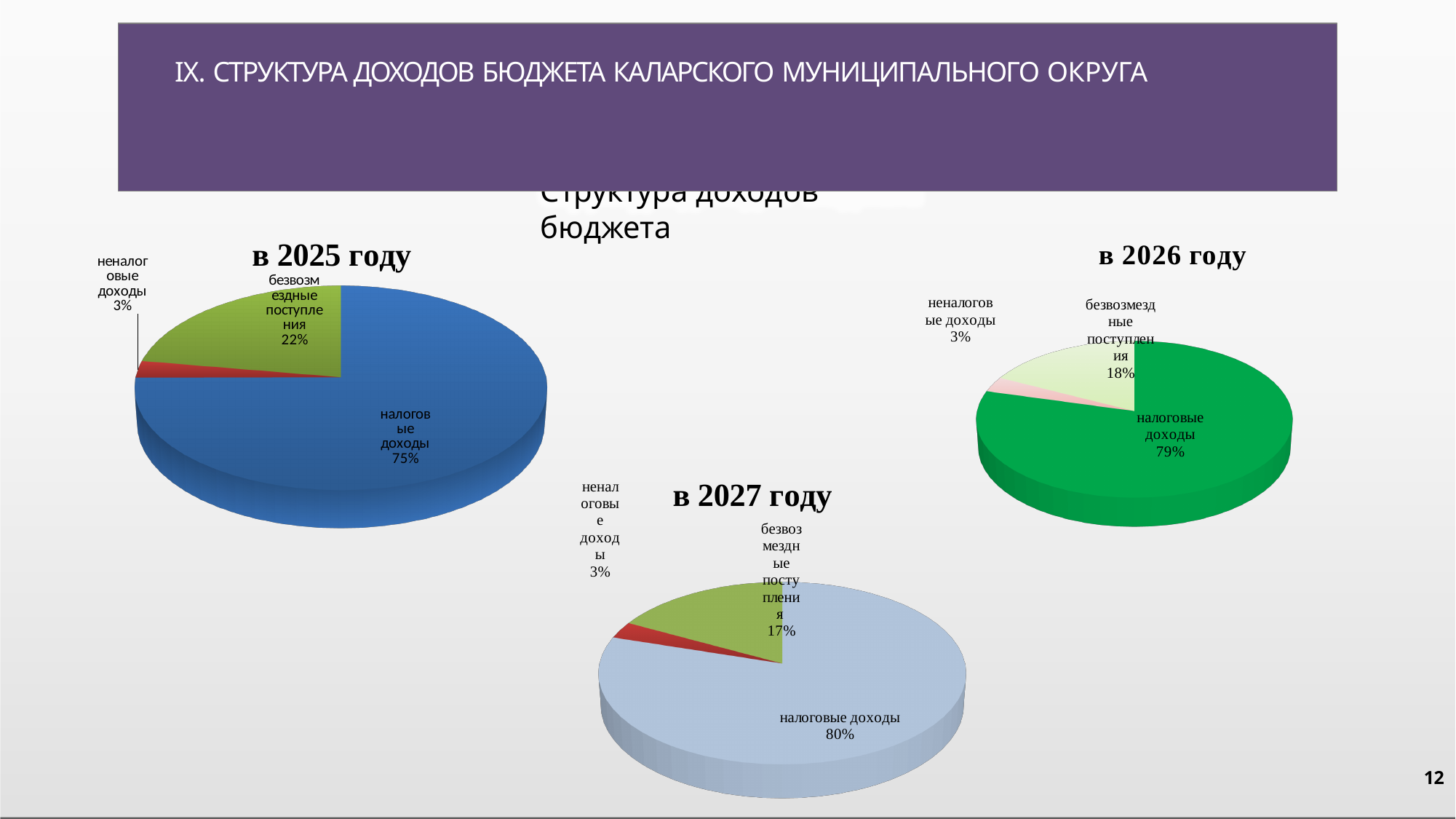
In the chart titled "в 2027 году", what share is shown for "налоговые доходы"? 80% In the chart titled "в 2027 году", what is the difference in percentage points between "налоговые доходы" and "безвозмездные поступления"? 63 In the chart titled "в 2025 году", which category has the largest share? налоговые доходы In the chart titled "в 2026 году", what share is shown for "налоговые доходы"? 79% In the chart titled "в 2025 году", what share is shown for "безвозмездные поступления"? 22% What type of chart is the chart titled "в 2027 году"? pie chart In the chart titled "в 2027 году", what share is shown for "неналоговые доходы"? 3% How many slices does the chart titled "в 2026 году" have? 3 In the chart titled "в 2025 году", what share is shown for "налоговые доходы"? 75% In the chart titled "в 2026 году", which category has the smallest share? неналоговые доходы In the chart titled "в 2026 году", what share is shown for "безвозмездные поступления"? 18% Which is larger: the share of "безвозмездные поступления" in the chart titled "в 2025 году" or in the chart titled "в 2027 году"? в 2025 году